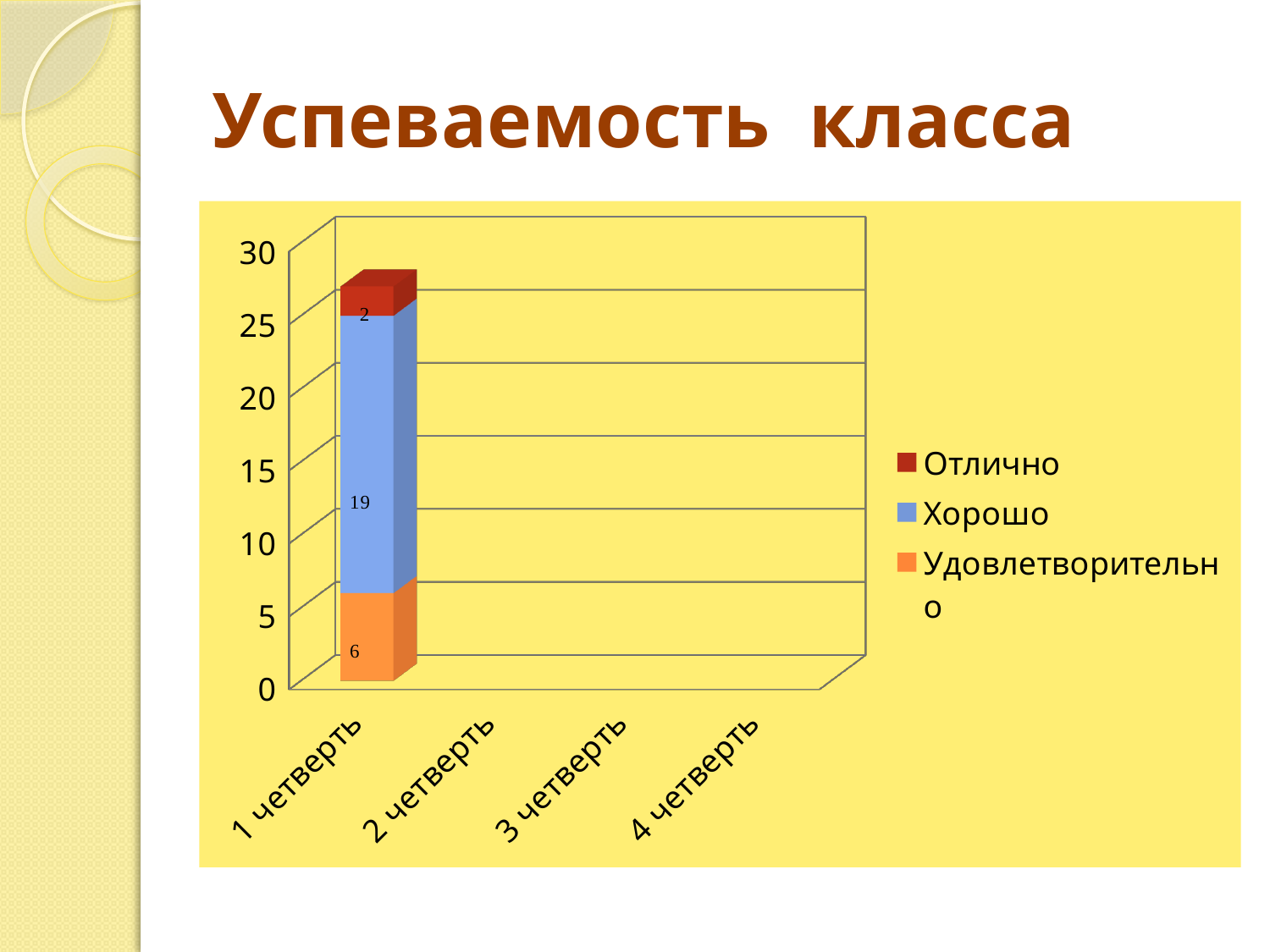
What is the title of the slide? Успеваемость класса How many series does the legend list? 3 How many categories are shown on the x axis? 4 Which series has the lowest value in 1 четверть? Отлично What is the value for Хорошо in 1 четверть? 19 What is the total of the stacked bar for 1 четверть? 27 What kind of chart is shown on the slide? Stacked bar chart Which series has the highest value in 1 четверть? Хорошо What is the value for Отлично in 1 четверть? 2 What is the value for Удовлетворительно in 1 четверть? 6 What is the difference between the Хорошо and Удовлетворительно values in 1 четверть? 13 In 1 четверть, which is larger: Удовлетворительно or Отлично? Удовлетворительно